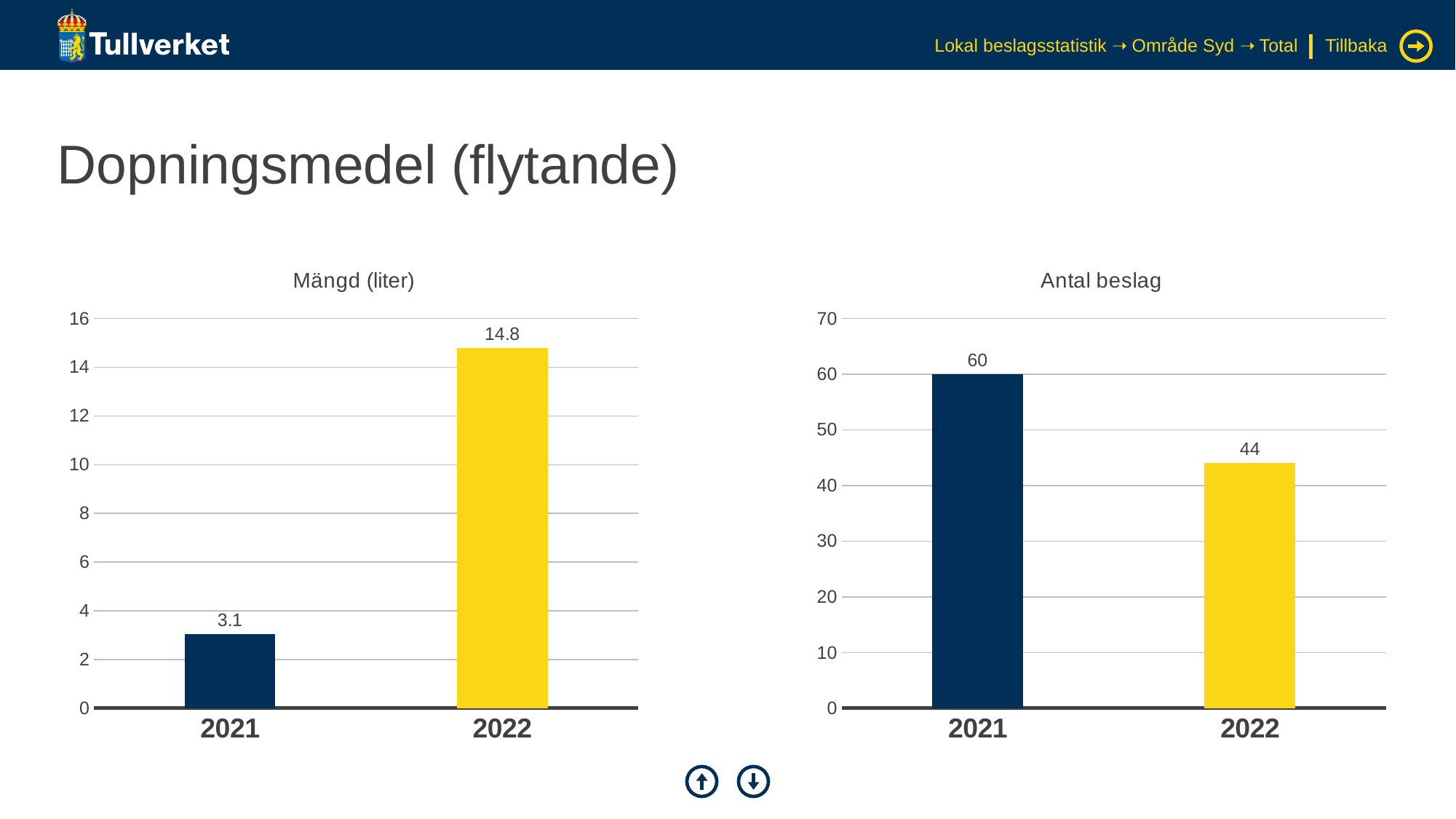
In the 'Antal beslag' chart, what is the value for 2021? 60 In the 'Mängd (liter)' chart, what is the value for 2022? 14.8 In the 'Mängd (liter)' chart, which year has the highest value? 2022 In the 'Antal beslag' chart, is the value for 2021 greater or less than 50? greater In the 'Antal beslag' chart, what is the value for 2022? 44 How many years are shown in the 'Mängd (liter)' chart? 2 In the 'Mängd (liter)' chart, what is the value for 2021? 3.1 In the 'Antal beslag' chart, which year has the lowest value? 2022 What kind of chart is the 'Antal beslag' chart? bar chart In the 'Antal beslag' chart, do the values rise or fall from 2021 to 2022? fall In the 'Mängd (liter)' chart, what is the difference between the 2022 and 2021 values? 11.7 In the 'Antal beslag' chart, what is the difference between the 2021 and 2022 values? 16